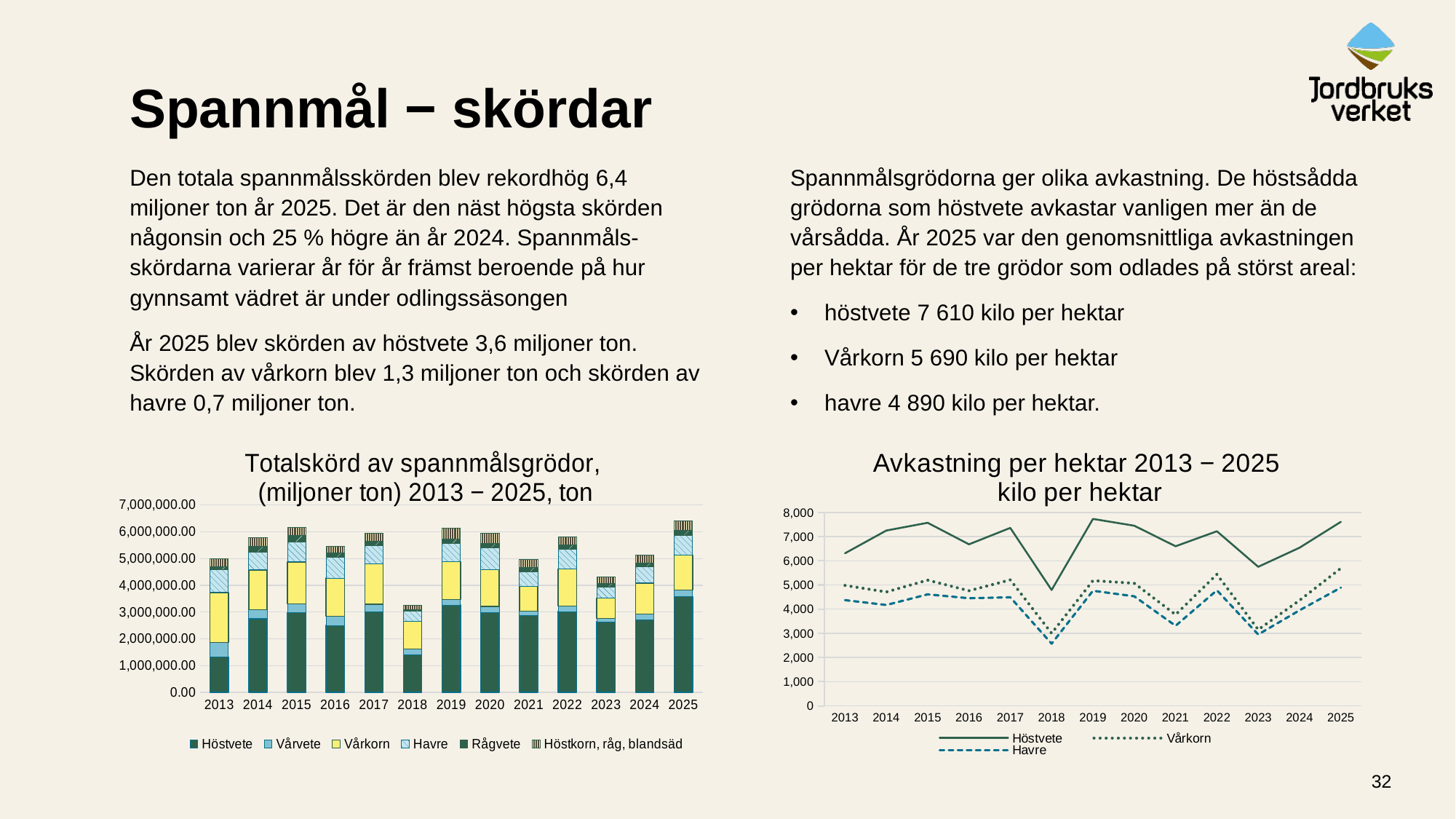
In the left chart 'Totalskörd av spannmålsgrödor', how many years are shown on the x axis? 13 What kind of chart is the left chart titled 'Totalskörd av spannmålsgrödor'? stacked bar chart What kind of chart is the right chart titled 'Avkastning per hektar 2013 − 2025'? line chart In the right chart 'Avkastning per hektar', does the Höstvete line rise or fall from 2023 to 2025? rise In the left chart 'Totalskörd av spannmålsgrödor', which year has the lowest total harvest? 2018 In the left chart 'Totalskörd av spannmålsgrödor', how many series does the legend list? 6 In the right chart 'Avkastning per hektar', is the Havre value for 2018 greater or less than 3,000? less In the left chart 'Totalskörd av spannmålsgrödor', is the total bar for 2025 greater or less than 6,000,000.00? greater In the right chart 'Avkastning per hektar', which series has the highest values across the years? Höstvete In the right chart 'Avkastning per hektar', is the Höstvete value for 2019 greater or less than 7,000? greater In the right chart 'Avkastning per hektar', how many series does the legend list? 3